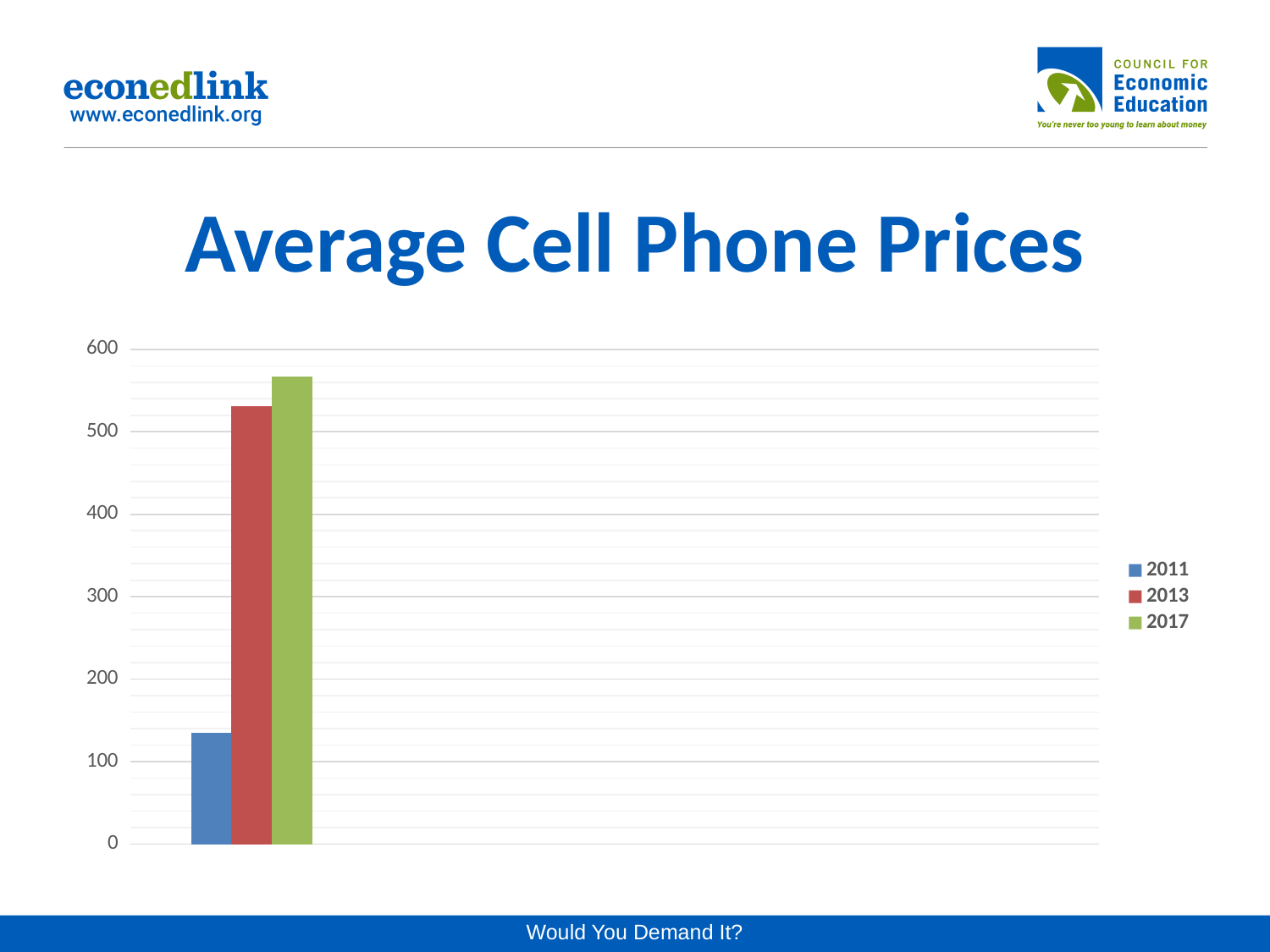
Is the value for 2011 greater or less than 200? less What kind of chart is shown on the slide? bar chart How many series does the legend list? 3 Which years are listed in the chart's legend? 2011, 2013, 2017 What is the title of the chart? Average Cell Phone Prices Is the value for 2013 greater or less than 500? greater Which year has the highest average cell phone price? 2017 Which is larger, the value for 2011 or the value for 2013? 2013 Is the value for 2011 greater or less than 100? greater Which year has the lowest average cell phone price? 2011 Do average cell phone prices rise or fall from 2011 to 2017? rise